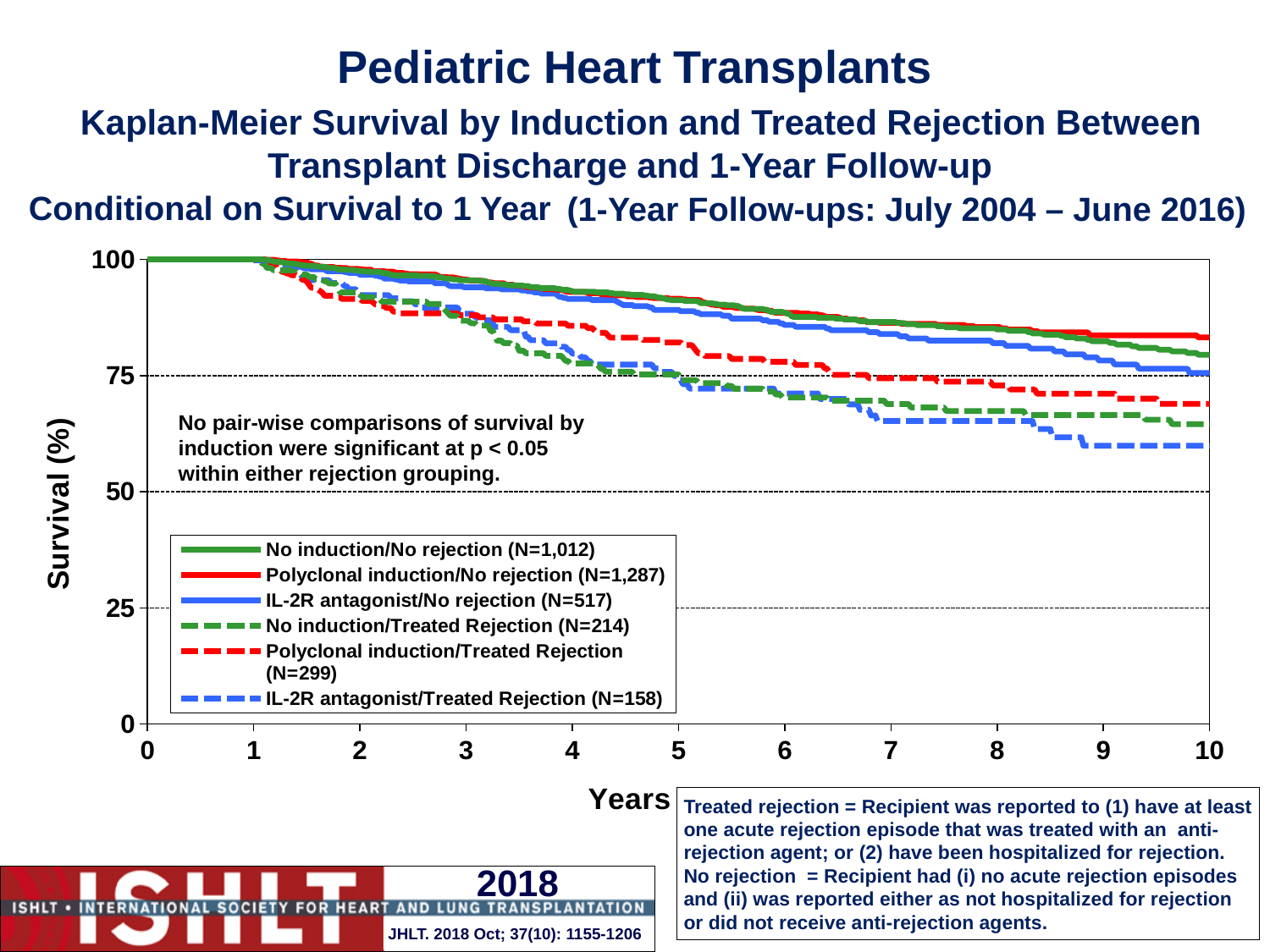
What is the label of the y axis? Survival (%) What kind of chart is shown on the slide? Line chart Which series has the lowest survival at year 10? IL-2R antagonist/Treated Rejection (N=158) At year 10, is the survival for IL-2R antagonist/Treated Rejection greater or less than 75? less What is the sample size (N) shown in the legend for No induction/No rejection? N=1,012 At year 10, is the survival for Polyclonal induction/No rejection greater or less than 75? greater Do the survival curves rise or fall as years increase? Fall How many series does the legend list? 6 At year 10, is the survival for IL-2R antagonist/Treated Rejection greater or less than 50? greater Which series has the highest survival at year 10? Polyclonal induction/No rejection (N=1,287) At year 10, which is higher: Polyclonal induction/No rejection or IL-2R antagonist/Treated Rejection? Polyclonal induction/No rejection